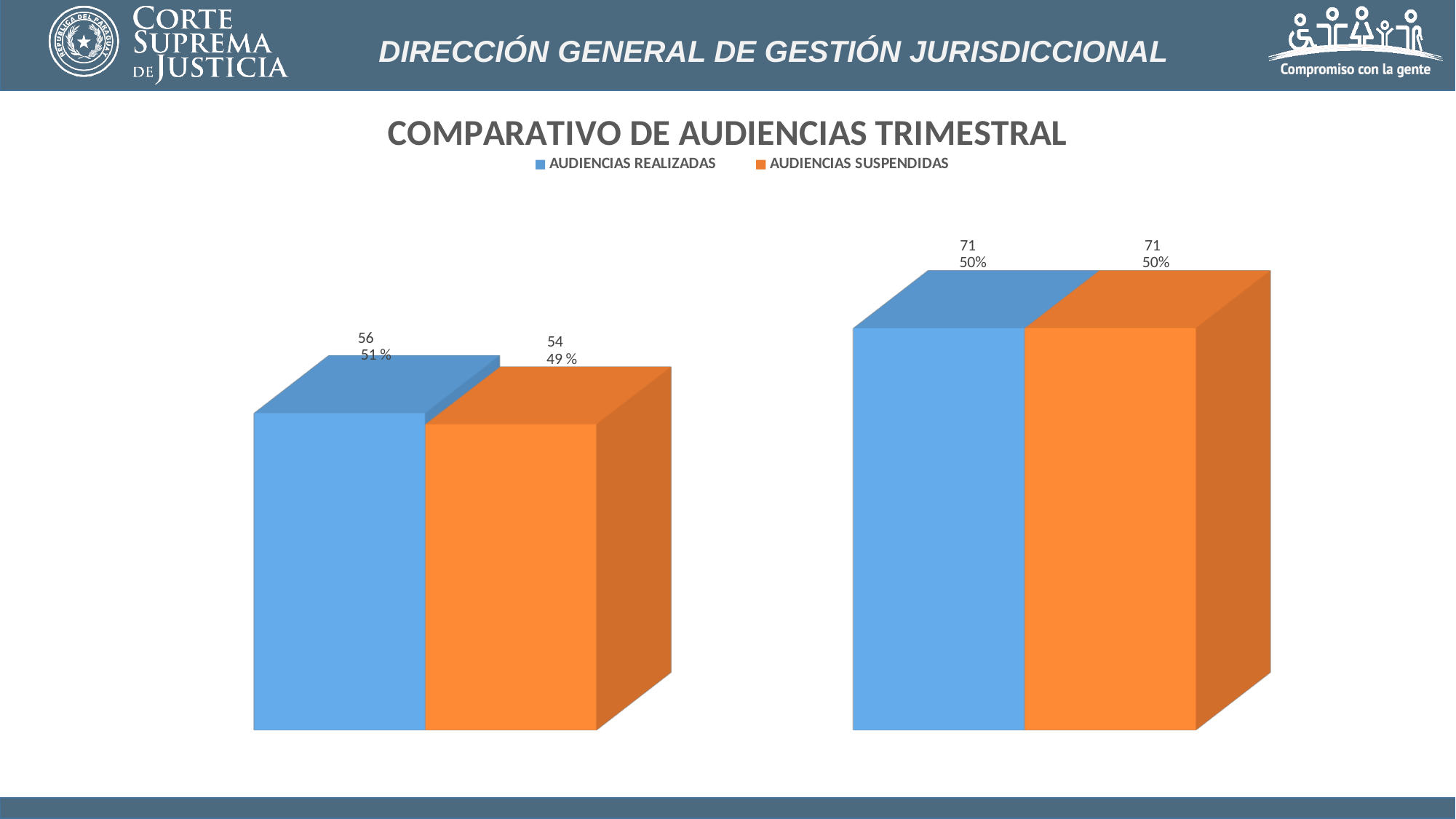
In the left group of bars, what is the difference between AUDIENCIAS REALIZADAS and AUDIENCIAS SUSPENDIDAS? 2 In the right group of bars, what is the value for AUDIENCIAS REALIZADAS? 71 How many groups of bars does the chart show? 2 In the left group of bars, what percentage is shown for AUDIENCIAS REALIZADAS? 51 % What is the total of AUDIENCIAS REALIZADAS and AUDIENCIAS SUSPENDIDAS in the right group of bars? 142 In the left group of bars, what is the value for AUDIENCIAS REALIZADAS? 56 What kind of chart is shown on the slide? bar chart In the left group of bars, what is the value for AUDIENCIAS SUSPENDIDAS? 54 What is the title of the chart? COMPARATIVO DE AUDIENCIAS TRIMESTRAL Which series is shown in orange in the chart? AUDIENCIAS SUSPENDIDAS In the right group of bars, what is the value for AUDIENCIAS SUSPENDIDAS? 71 How many series does the chart legend list? 2